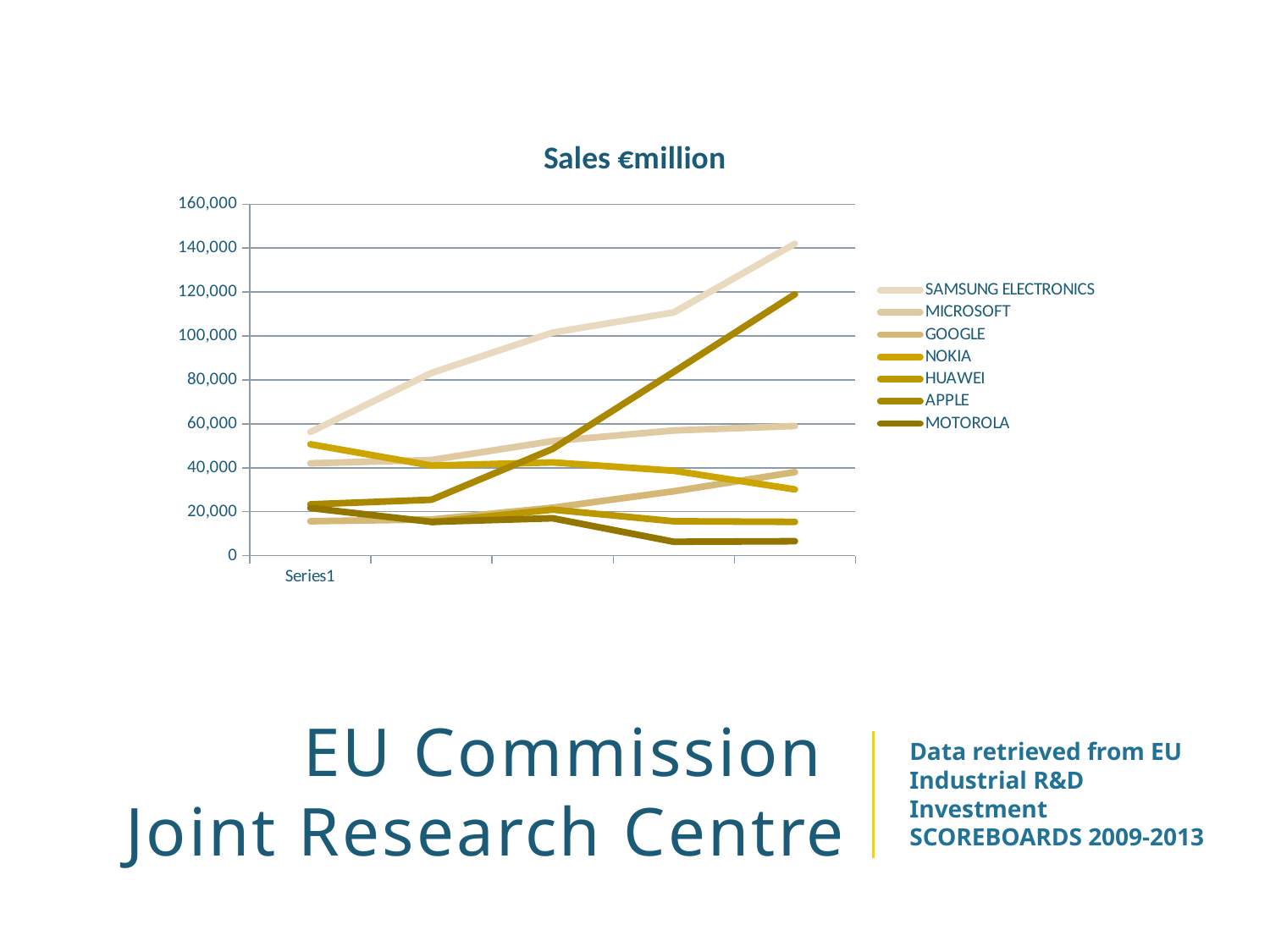
Is the value for MOTOROLA at the rightmost point greater or less than 20,000? less Do the values for APPLE rise or fall from left to right? rise What kind of chart is shown on the slide? line chart How many points along the x axis does each line have? 5 Which series has the lowest value at the rightmost point of the chart? MOTOROLA What is the title of the chart? Sales €million Which series has the highest value at the rightmost point of the chart? SAMSUNG ELECTRONICS Do the values for SAMSUNG ELECTRONICS rise or fall from left to right? rise Is the value for APPLE at the rightmost point greater or less than 100,000? greater At the rightmost point, which is larger: APPLE or MICROSOFT? APPLE How many series does the legend list? 7 Do the values for NOKIA rise or fall from left to right? fall